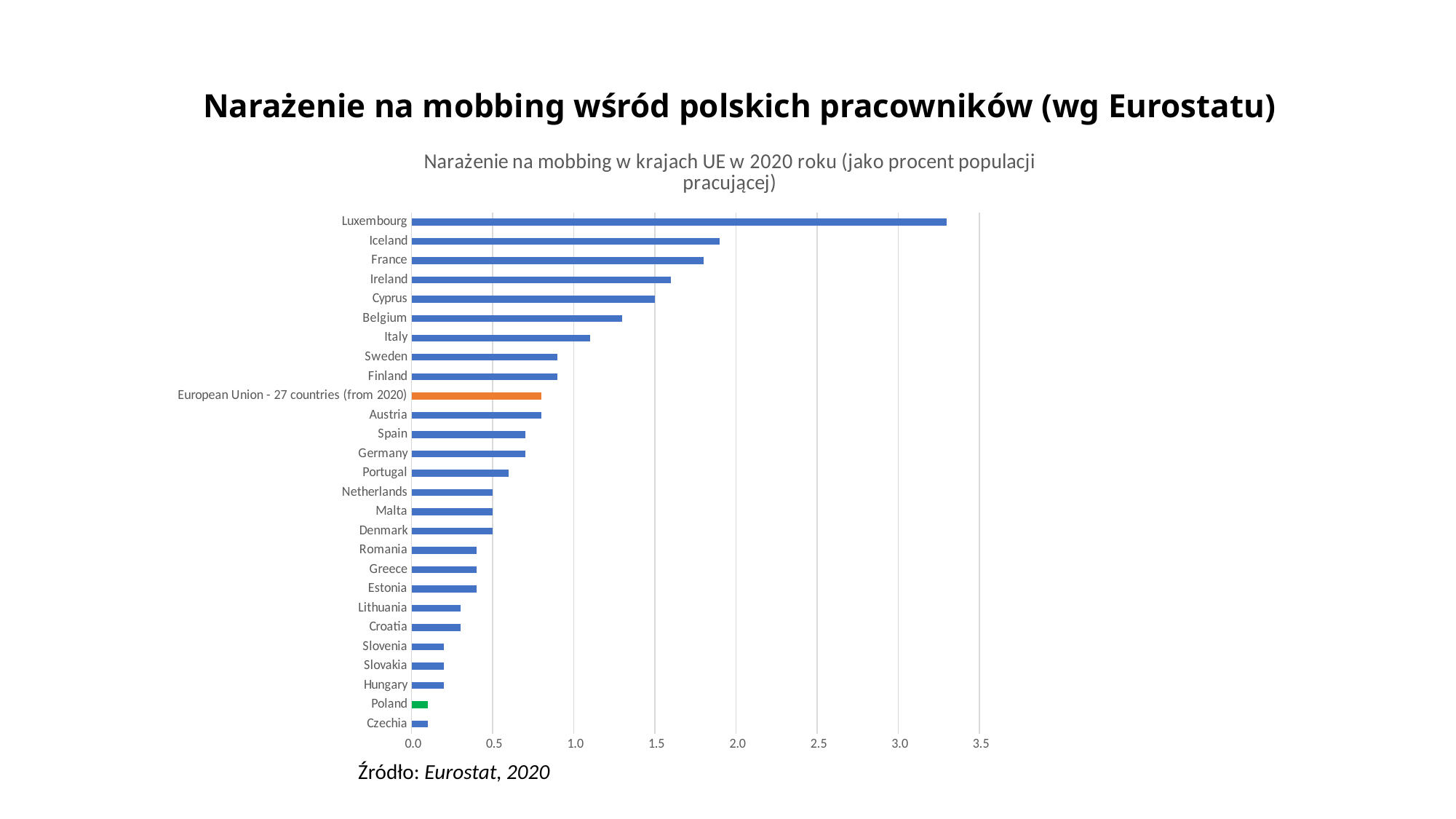
What kind of chart is shown on the slide? bar chart Is the value for Iceland greater or less than 2.0? less How many categories (bars) are plotted in the chart? 27 Which country has the highest value in the chart? Luxembourg Is the value for Belgium greater or less than 1.5? less Is the value for Poland greater or less than 0.5? less Which has a larger value, Hungary or Austria? Austria What is the title of the chart? Narażenie na mobbing w krajach UE w 2020 roku (jako procent populacji pracującej) What colour is the bar for Poland? green Which has a larger value, Luxembourg or Iceland? Luxembourg